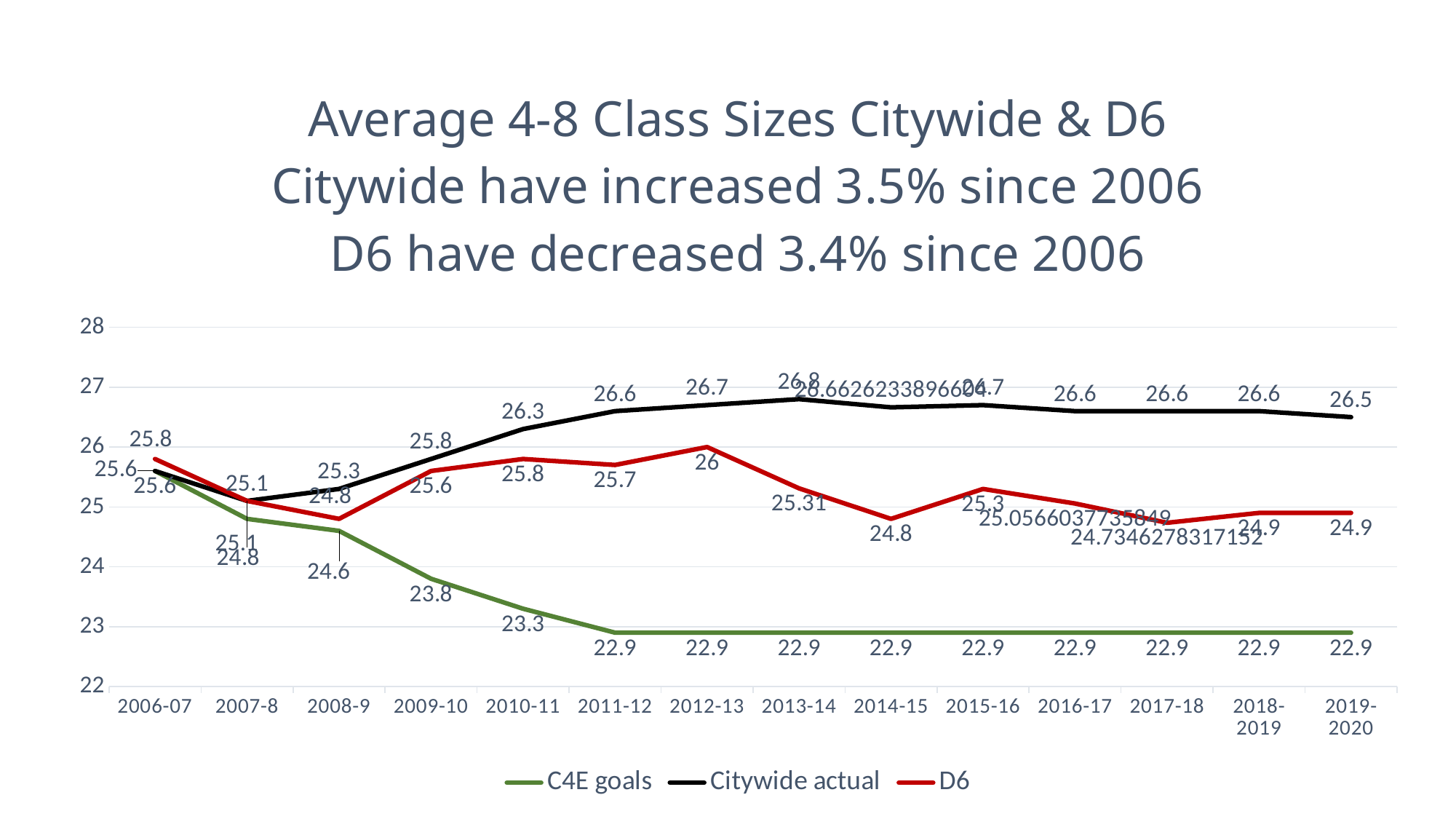
What is the D6 value for 2012-13? 26 In 2012-13, which is larger: the Citywide actual value or the D6 value? Citywide actual Is the D6 value for 2017-18 greater or less than 25? less What is the C4E goals value for 2009-10? 23.8 What is the Citywide actual value for 2010-11? 26.3 How many series does the legend list? 3 What kind of chart is shown on the slide? line chart What is the lowest value shown for the C4E goals series? 22.9 In which year does the Citywide actual series reach its highest value? 2013-14 What is the difference between the Citywide actual value and the C4E goals value in 2019-2020? 3.6 What is the Citywide actual value for 2019-2020? 26.5 How many school years are shown on the x axis? 14